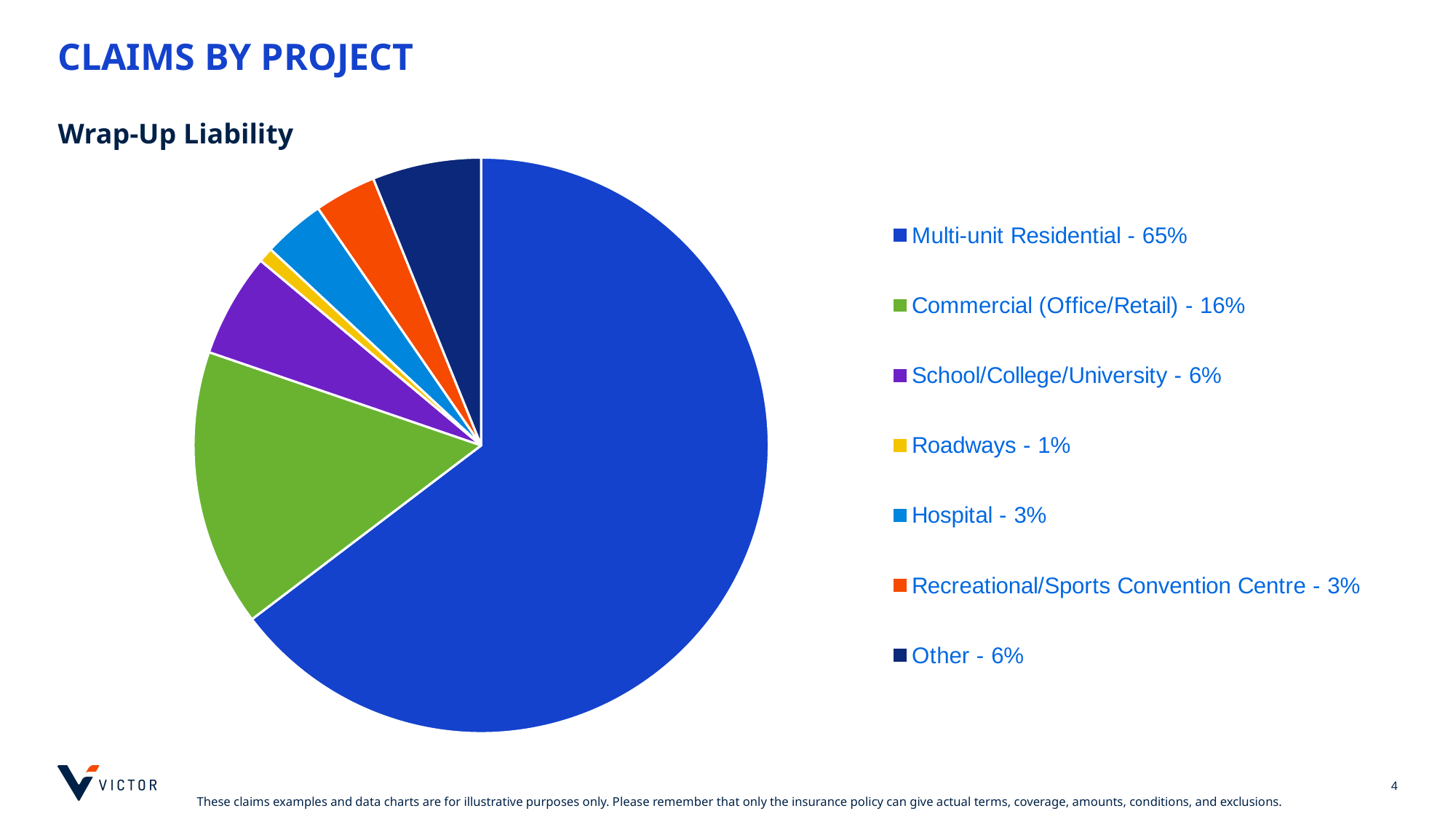
What share of Wrap-Up Liability claims is Multi-unit Residential? 65% What colour is the Recreational/Sports Convention Centre slice? orange What kind of chart is shown on the slide? pie chart What is the difference in percentage points between Multi-unit Residential and Commercial (Office/Retail)? 49 What share of claims is Commercial (Office/Retail)? 16% Which is larger, the share for School/College/University or the share for Hospital? School/College/University What is the difference in percentage points between Commercial (Office/Retail) and Other? 10 What share of claims is Roadways? 1% Which project type has the smallest share of claims? Roadways How many categories does the pie chart have? 7 Which project type has the largest share of claims? Multi-unit Residential